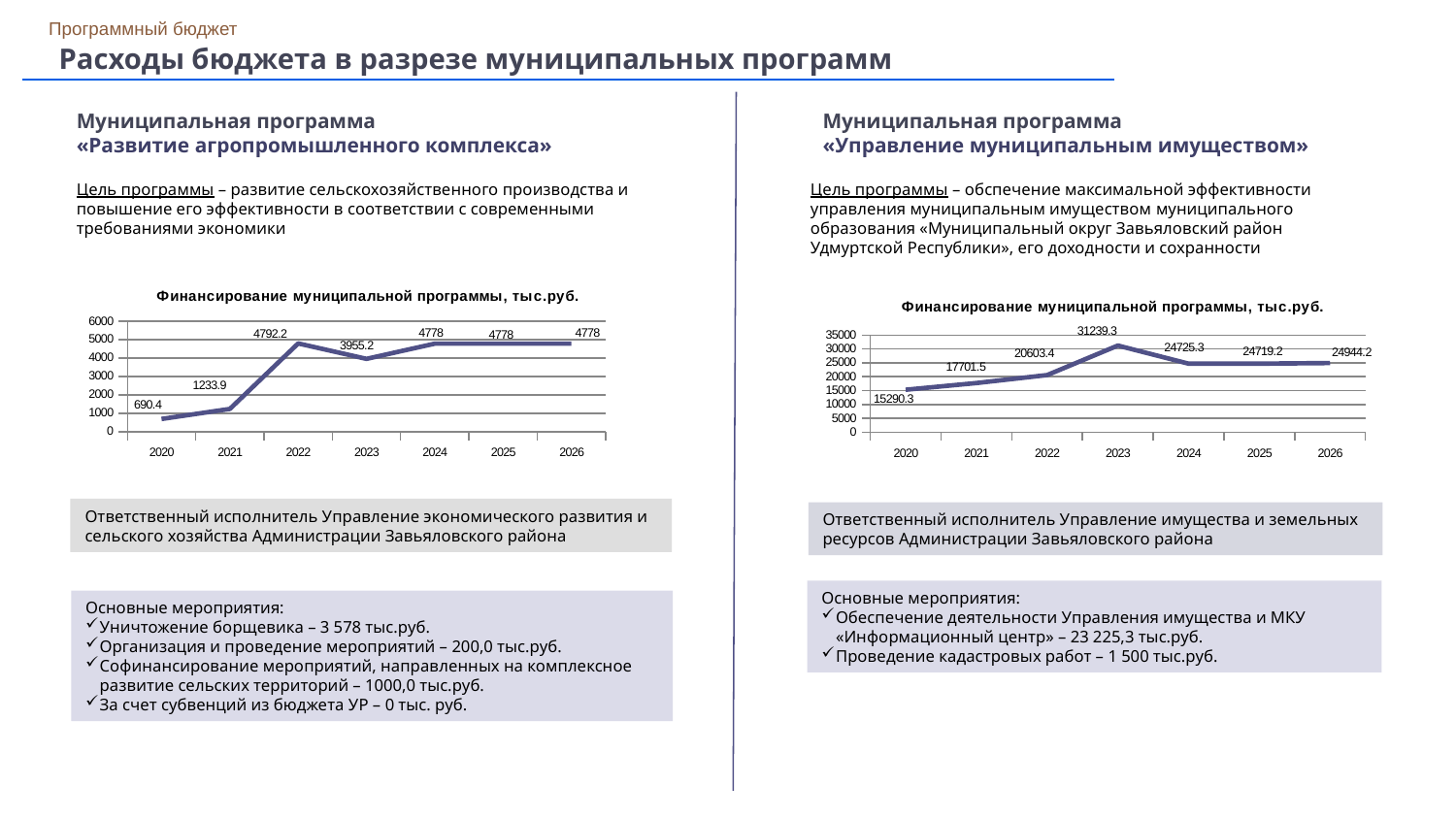
How many years are plotted in the left chart (Развитие агропромышленного комплекса)? 7 In the left chart (Развитие агропромышленного комплекса), which year has the lowest value? 2020 In the right chart (Управление муниципальным имуществом), is the value for 2021 larger or smaller than the value for 2022? smaller In the left chart (Развитие агропромышленного комплекса), what is the value for 2020? 690.4 In the left chart (Развитие агропромышленного комплекса), what is the value for 2023? 3955.2 In the right chart (Управление муниципальным имуществом), which year has the lowest value? 2020 In the right chart (Управление муниципальным имуществом), what is the difference between the values for 2021 and 2020? 2411.2 In the left chart (Развитие агропромышленного комплекса), what is the difference between the values for 2022 and 2023? 837 In the right chart (Управление муниципальным имуществом), what is the value for 2026? 24944.2 In the left chart (Развитие агропромышленного комплекса), which year has the highest value? 2022 In the right chart (Управление муниципальным имуществом), what is the value for 2023? 31239.3 What type of chart is shown on the left side of the slide (under «Развитие агропромышленного комплекса»)? line chart